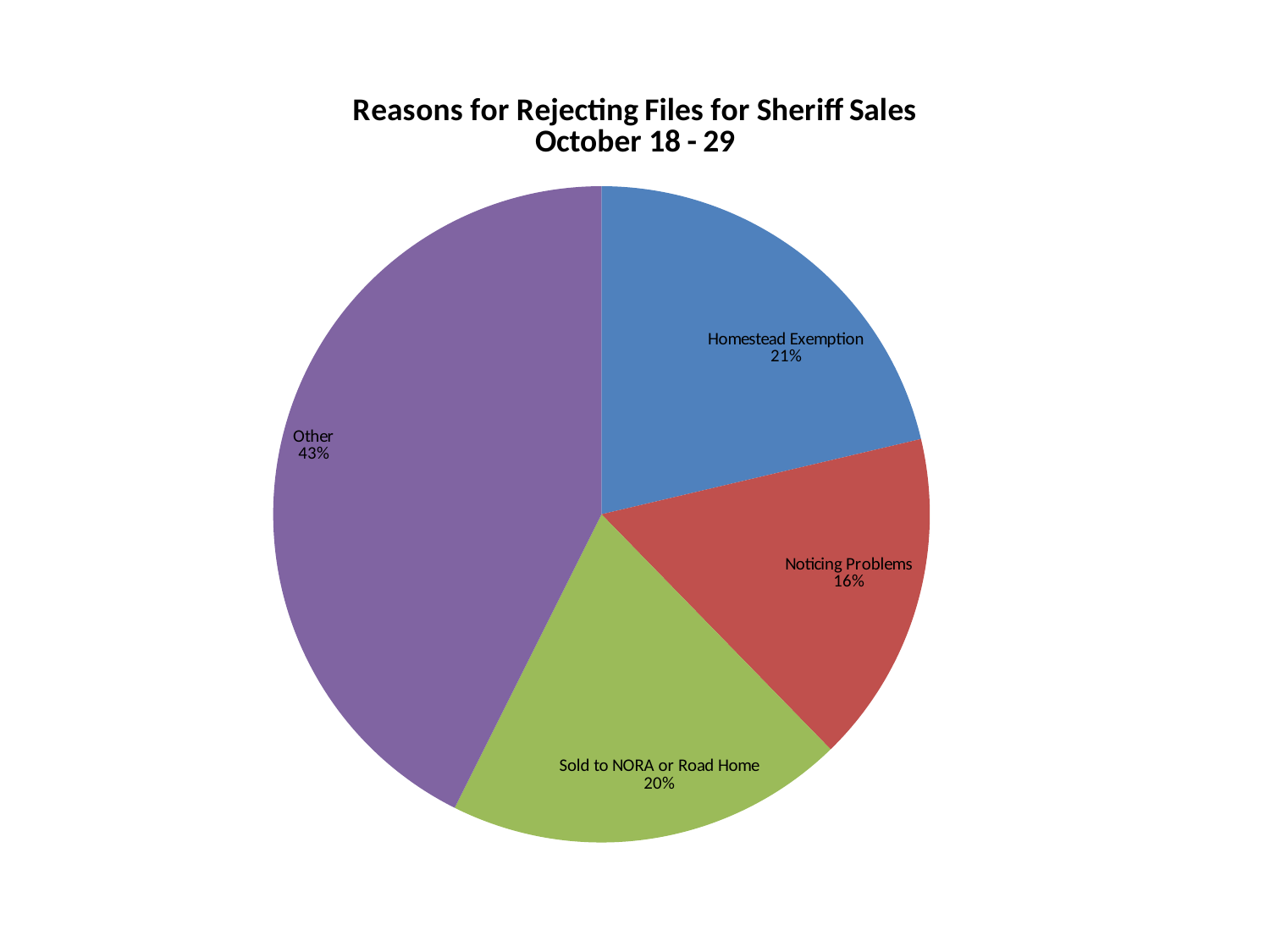
What share of the pie is labelled Other? 43% What is the title of the chart? Reasons for Rejecting Files for Sheriff Sales October 18 - 29 What kind of chart is shown on the slide? Pie chart Which category has the smallest slice of the pie? Noticing Problems What percentage is shown for Noticing Problems? 16% Which category has the largest slice of the pie? Other What percentage is shown for Sold to NORA or Road Home? 20% What is the difference in percentage points between Other and Homestead Exemption? 22 What is the difference in percentage points between Sold to NORA or Road Home and Noticing Problems? 4 What percentage is shown for Homestead Exemption? 21% Which is larger, the share for Homestead Exemption or the share for Noticing Problems? Homestead Exemption How many categories are shown in the pie chart? 4